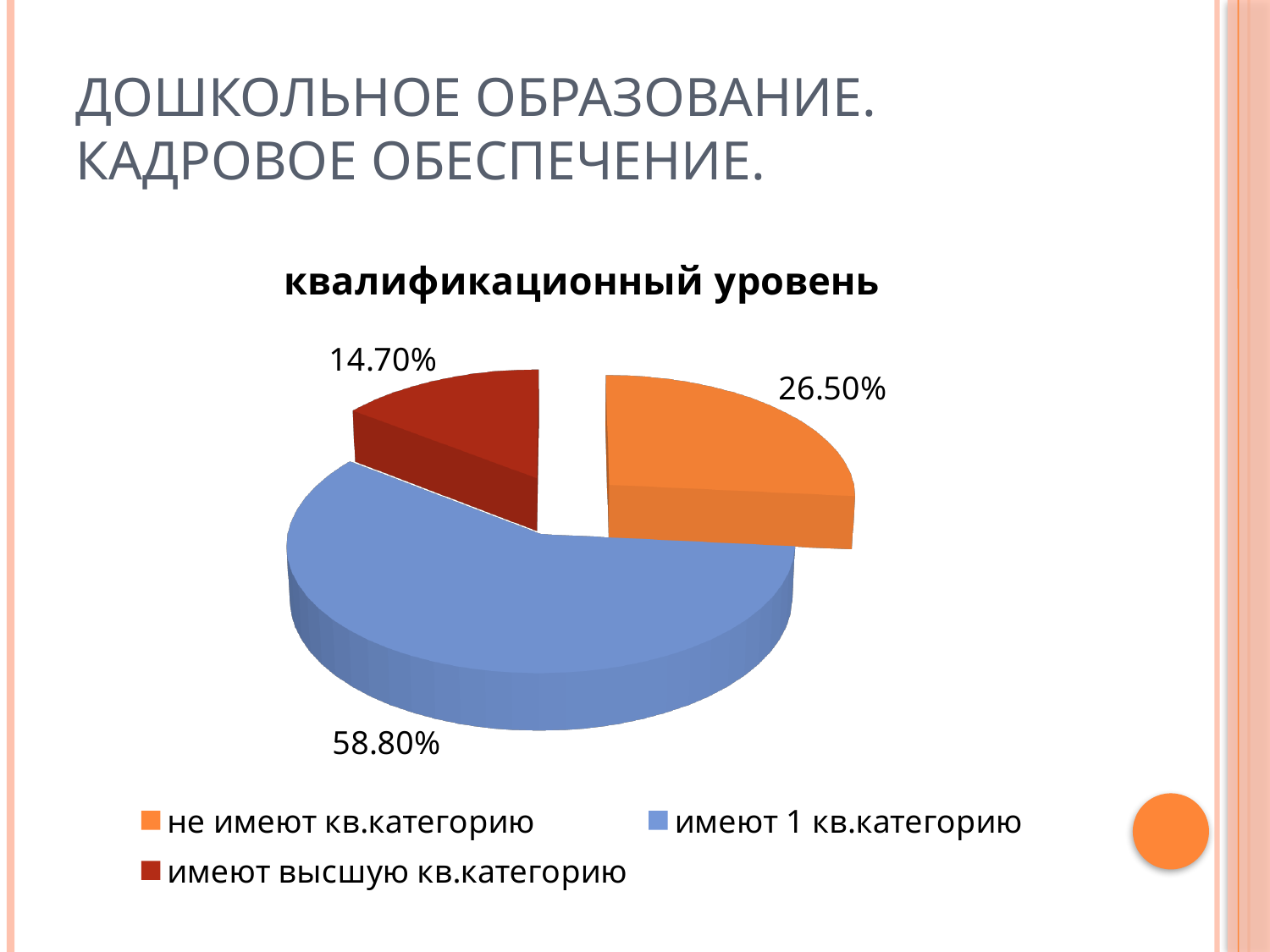
Which category has the smallest share of the pie? имеют высшую кв.категорию How many entries does the legend list? 3 What is the value for 'имеют 1 кв.категорию'? 58.80% What is the title of the chart? квалификационный уровень What is the value for 'имеют высшую кв.категорию'? 14.70% What is the difference between the shares for 'имеют 1 кв.категорию' and 'не имеют кв.категорию'? 32.30% Which is larger: the share for 'не имеют кв.категорию' or for 'имеют высшую кв.категорию'? не имеют кв.категорию What colour is the slice for 'имеют высшую кв.категорию'? dark red What kind of chart is shown on the slide? pie chart What is the value for 'не имеют кв.категорию'? 26.50% Which category has the largest share of the pie? имеют 1 кв.категорию How many slices does the pie chart have? 3